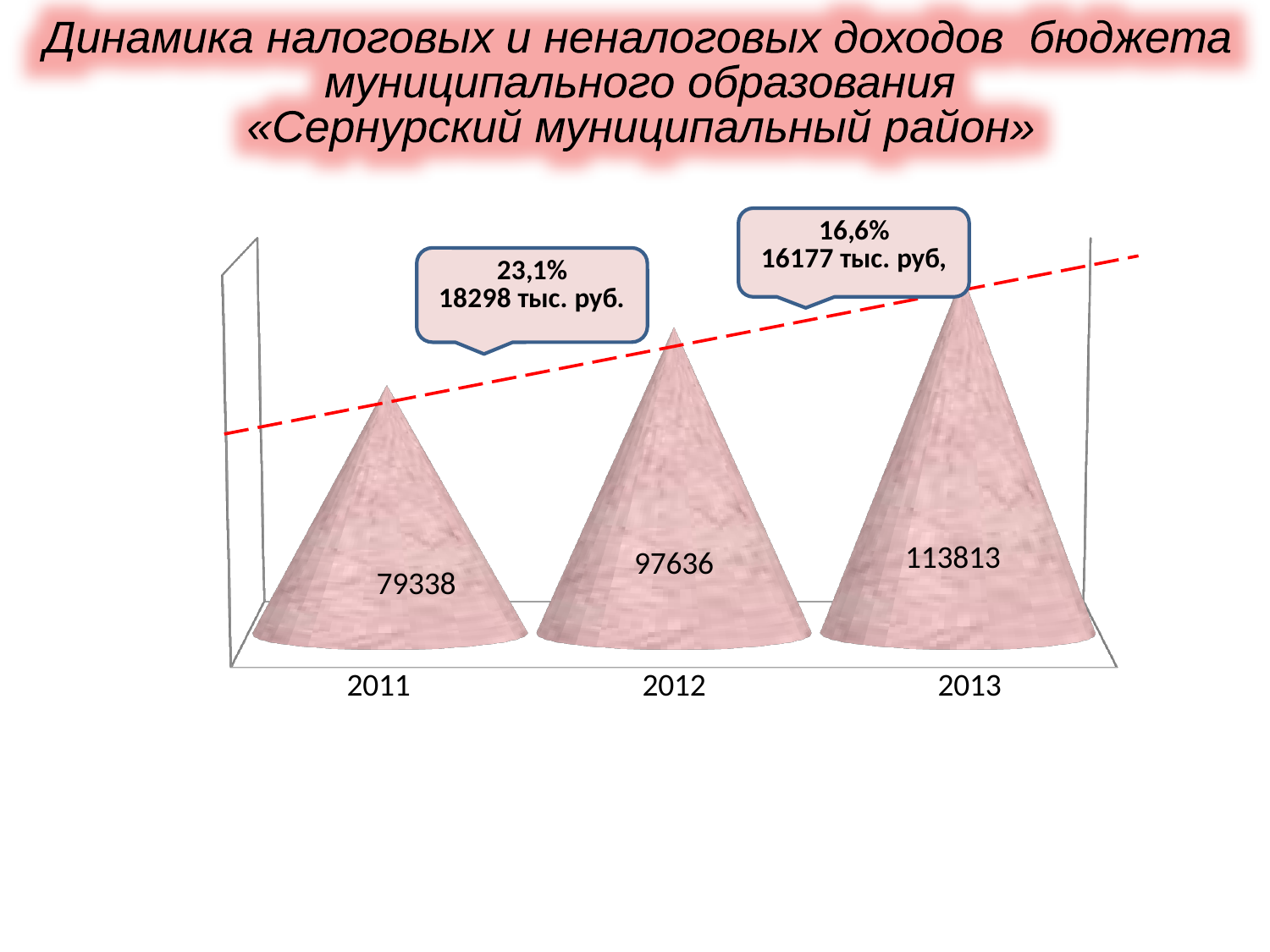
Do the values rise or fall from 2011 to 2013? rise What is the difference between the values for 2013 and 2012? 16177 How many years are shown on the x axis? 3 What is the value for 2013? 113813 Which year has the highest value? 2013 What percentage growth is shown in the callout between 2011 and 2012? 23,1% What is the value for 2011? 79338 What is the difference between the values for 2012 and 2011? 18298 What percentage growth is shown in the callout between 2012 and 2013? 16,6% What is the value for 2012? 97636 Which year has the lowest value? 2011 Which is larger, the value for 2012 or the value for 2013? 2013